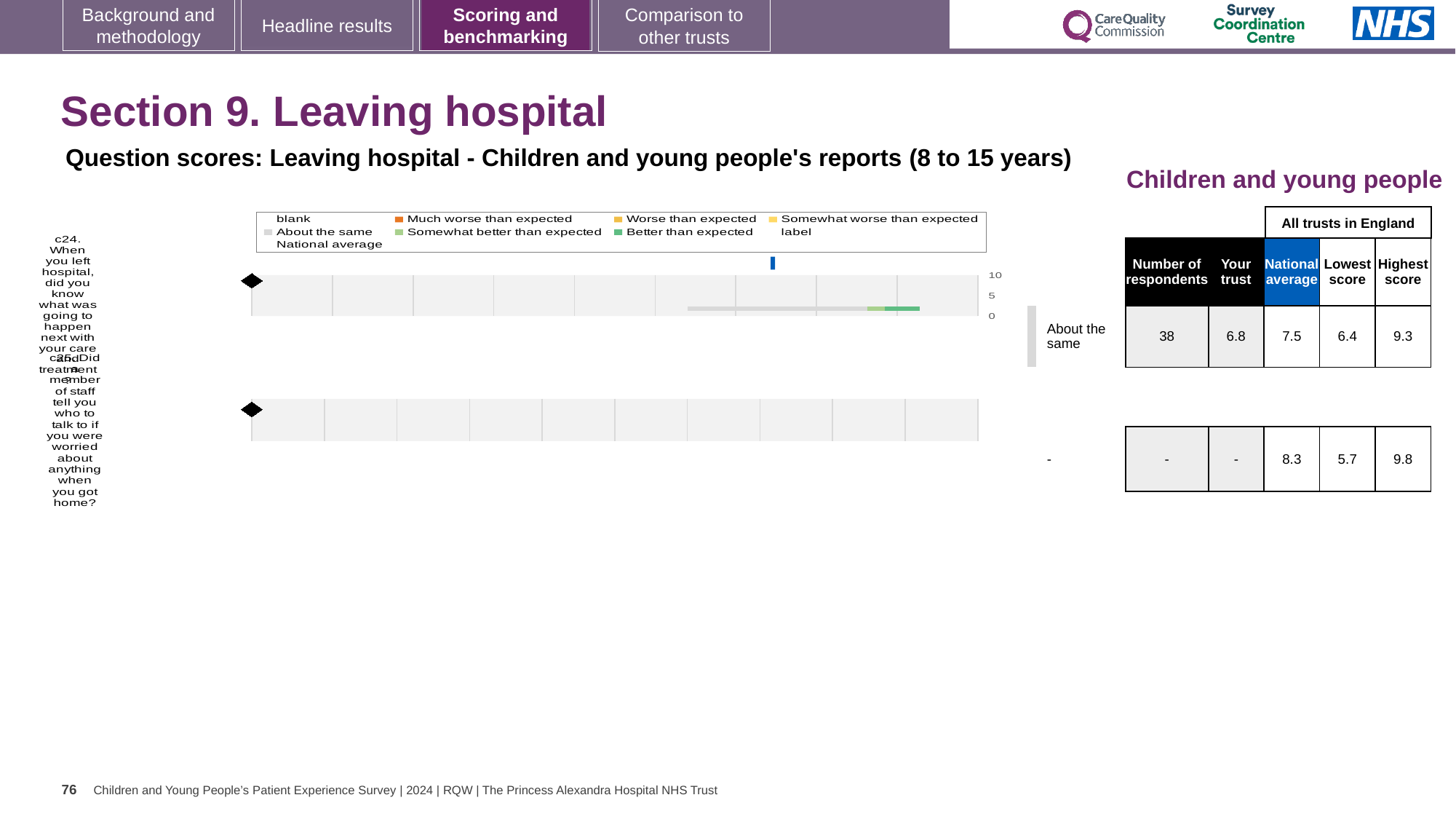
What is the difference between the highest score and the lowest score for question c25? 4.1 How many entries does the legend of the Leaving hospital chart list? 9 What kind of chart is used to show the question scores for Leaving hospital? Bar chart What is the national average score for question c25 (Did a member of staff tell you who to talk to if you were worried about anything when you got home)? 8.3 For question c24, which is larger: the trust's score or the national average? National average What is the 'Your trust' score for question c24 (When you left hospital, did you know what was going to happen next with your care and treatment)? 6.8 How many questions (categories) are plotted in the Leaving hospital chart? 2 What is the difference between the highest score and the lowest score for question c24? 2.9 What is the national average score for question c24? 7.5 What benchmark category is shown for question c24? About the same What is the highest score among all trusts in England for question c24? 9.3 How many respondents answered question c24? 38